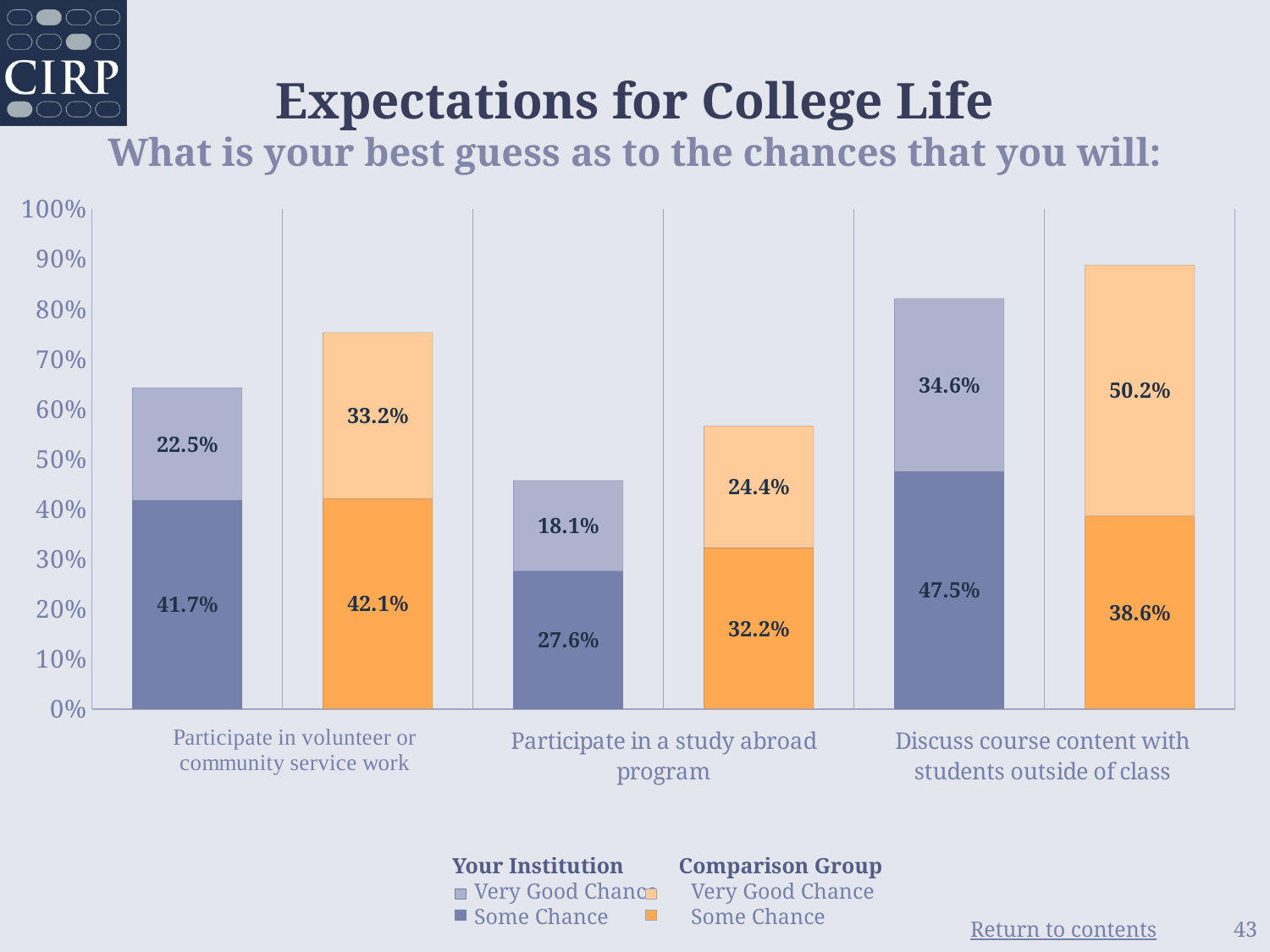
For 'Discuss course content with students outside of class', which is larger: Your Institution's 'Some Chance' value or the Comparison Group's 'Some Chance' value? Your Institution Which category has the lowest 'Very Good Chance' value for the Comparison Group? Participate in a study abroad program What is the 'Some Chance' value for Your Institution for 'Participate in volunteer or community service work'? 41.7% What is the 'Very Good Chance' value for the Comparison Group for 'Discuss course content with students outside of class'? 50.2% Which category has the highest 'Some Chance' value for Your Institution? Discuss course content with students outside of class What is the difference between the Comparison Group's and Your Institution's 'Very Good Chance' values for 'Participate in volunteer or community service work'? 10.7% What is the 'Very Good Chance' value for Your Institution for 'Participate in a study abroad program'? 18.1% How many categories are shown on the x axis? 3 What is the total of the stacked bar for Your Institution for 'Participate in a study abroad program'? 45.7% What is the total of the stacked bar for the Comparison Group for 'Discuss course content with students outside of class'? 88.8% How many series does the legend list? 4 What kind of chart is shown on the slide? Stacked bar chart